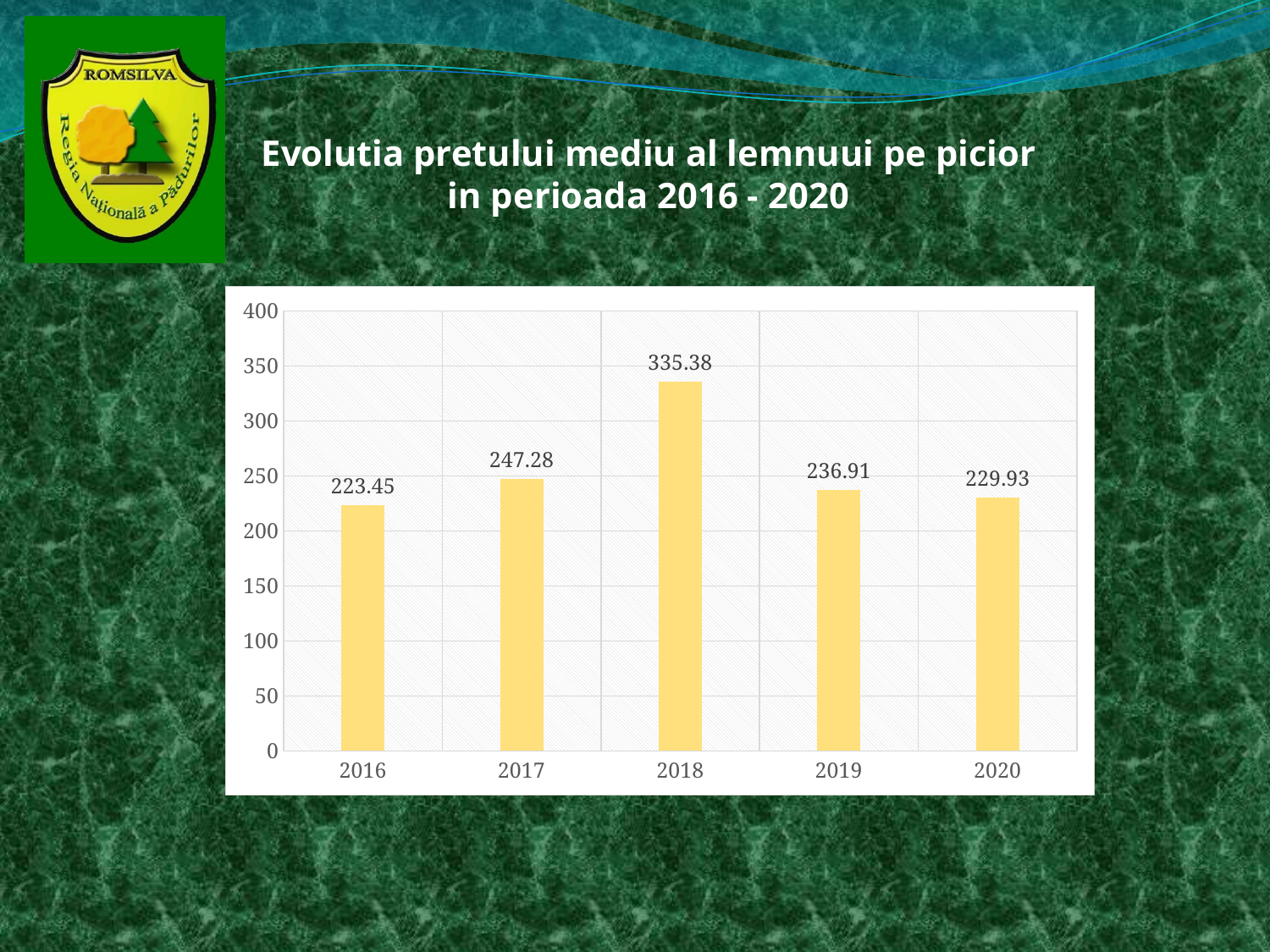
Do the values rise or fall from 2018 to 2020? fall What is the difference between the values for 2018 and 2017? 88.10 What kind of chart is shown on the slide? bar chart Is the value for 2018 greater or less than 300? greater Which year has the lowest value? 2016 What is the value for 2018? 335.38 Which year has the highest value? 2018 What is the value for 2020? 229.93 Which is larger, the value for 2017 or the value for 2019? 2017 What is the value for 2016? 223.45 How many years are shown on the x axis? 5 What is the difference between the values for 2019 and 2020? 6.98